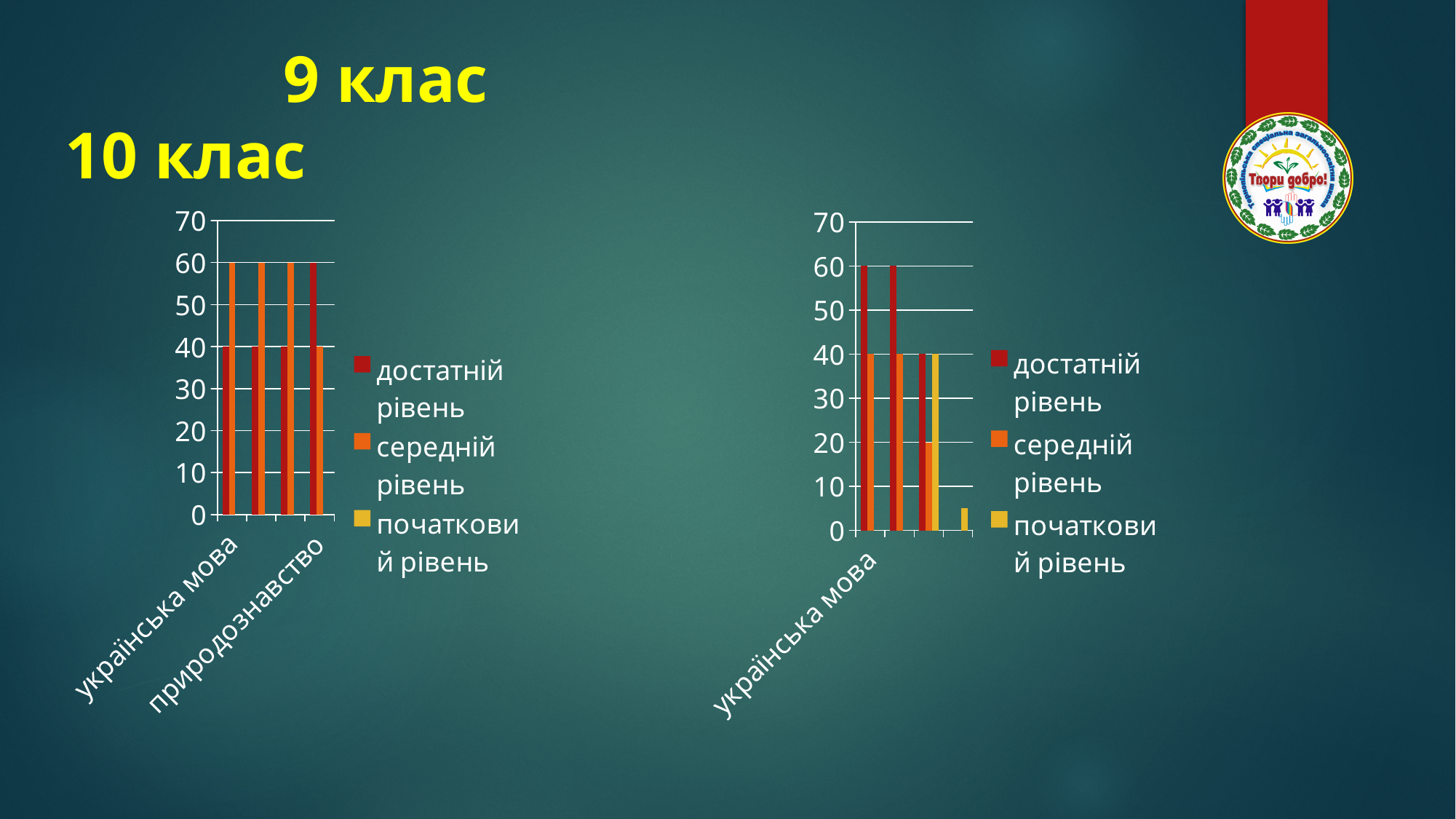
In the right chart, what is the value of середній рівень for українська мова? 40 In the right chart, which is larger for українська мова: достатній рівень or середній рівень? достатній рівень In the right chart, what is the difference between достатній рівень and середній рівень for українська мова? 20 In the left chart, what is the difference between середній рівень and достатній рівень for природознавство? 20 In the left chart, what is the value of середній рівень for українська мова? 60 In the right chart, what is the value of достатній рівень for українська мова? 60 In the left chart, what is the value of середній рівень for природознавство? 40 How many series does the legend of the left chart list? 3 What kind of chart is the left chart? bar chart In the left chart, what is the value of достатній рівень for українська мова? 40 In the left chart, which is larger for українська мова: достатній рівень or середній рівень? середній рівень What is the first entry in the legend of the right chart? достатній рівень